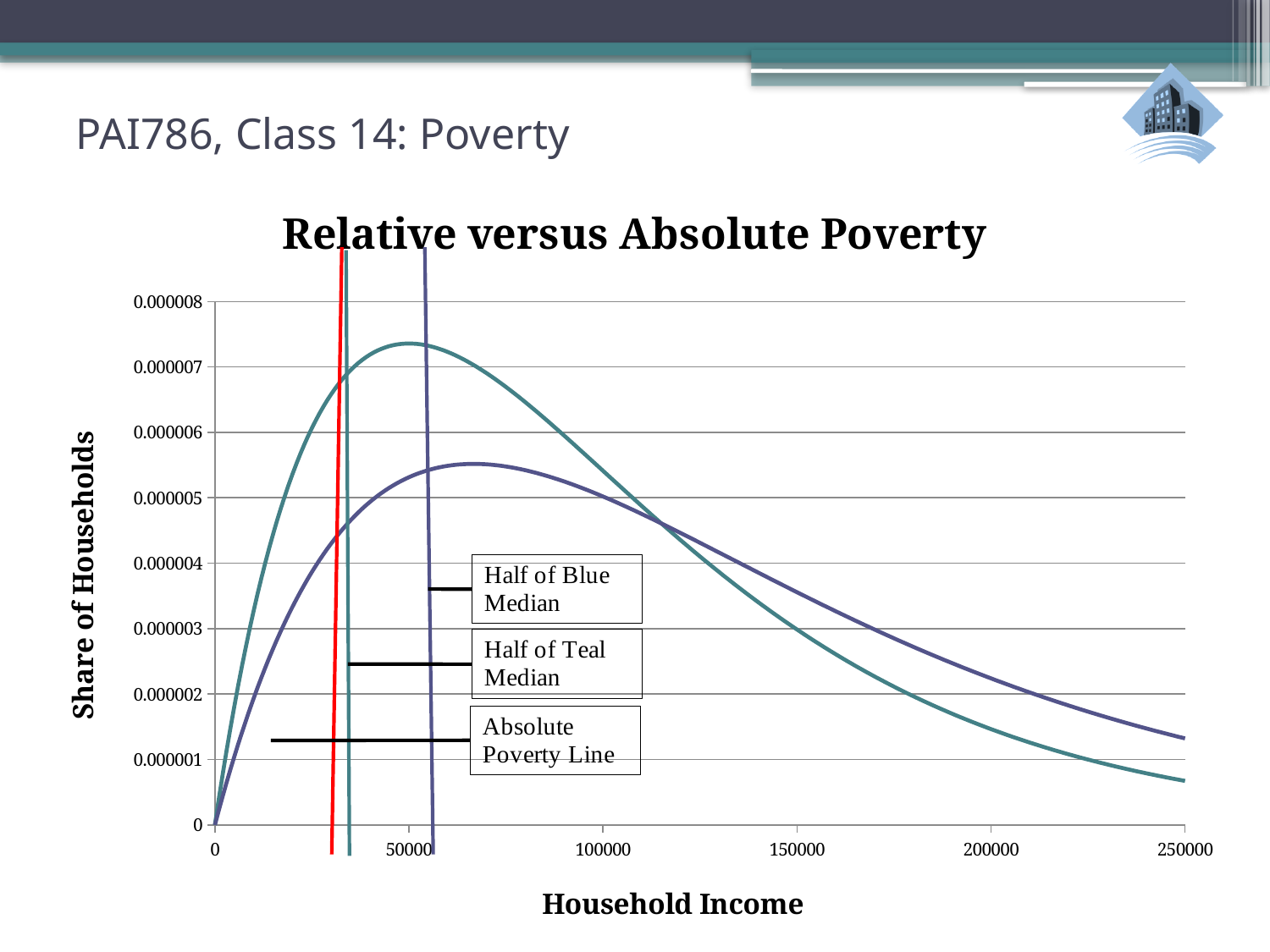
Which curve reaches the higher peak, the teal curve or the blue curve? Teal What is the title of the chart? Relative versus Absolute Poverty Is the peak of the teal curve greater or less than 0.000007? greater What is the label of the x axis of the chart? Household Income How many labelled vertical reference lines are marked on the chart? 3 Do the teal and blue curves rise or fall as household income increases from 100000 to 250000? Fall Is the Absolute Poverty Line at a household income greater or less than 50000? less At a household income of 250000, is the teal curve's value greater or less than 0.000001? less What kind of chart is shown on the slide? Line chart